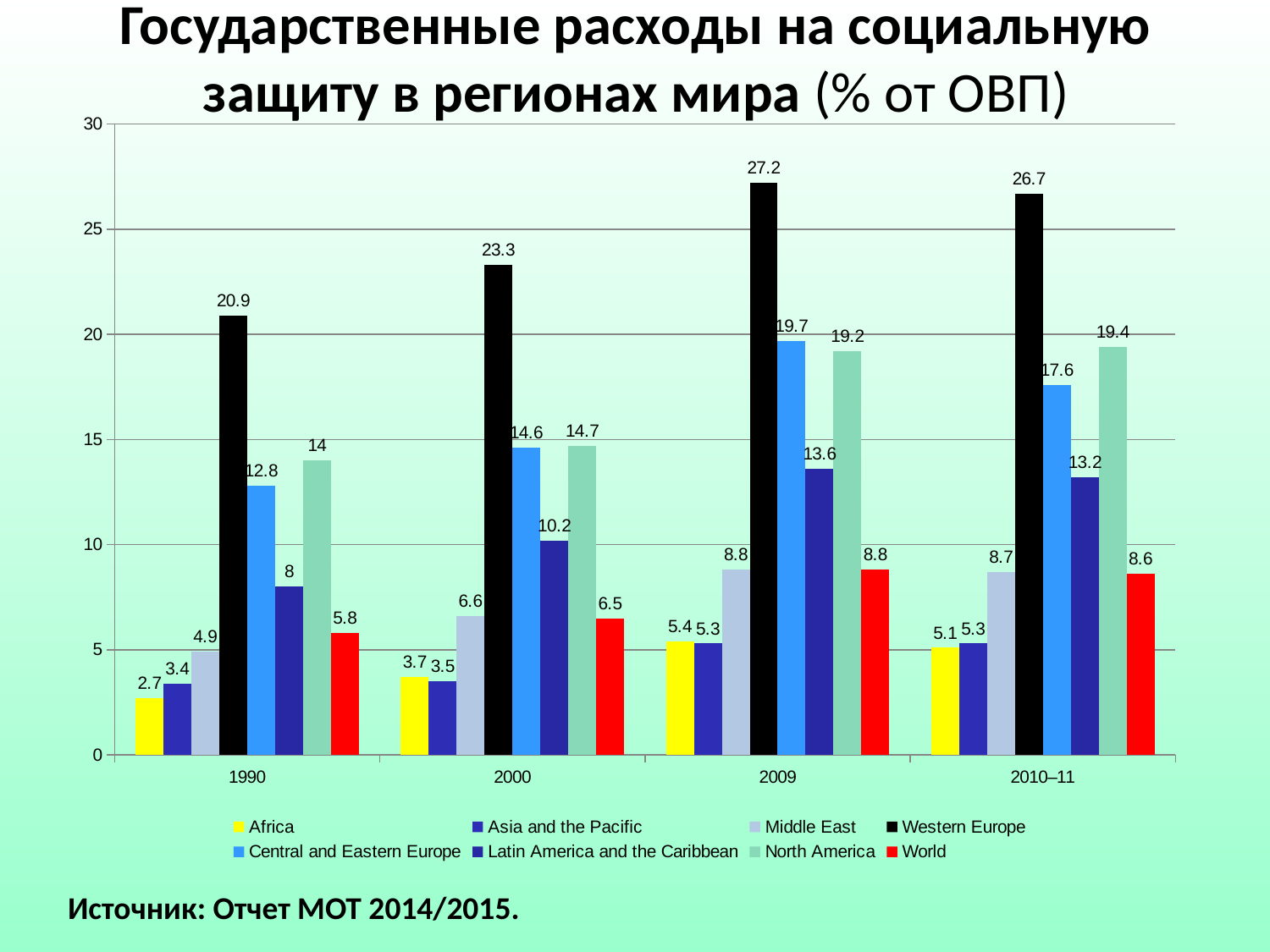
What is the difference between the North America values for 2010–11 and 2000? 4.7 Which region has the highest value in 2000? Western Europe What is the value for Western Europe in 2009? 27.2 Which region has the lowest value in 1990? Africa What is the value for World in 1990? 5.8 What kind of chart is shown on the slide? Bar chart In 2009, which is larger: Central and Eastern Europe or North America? Central and Eastern Europe Does the value for Western Europe rise or fall from 1990 to 2009? Rise What is the value for Latin America and the Caribbean in 2000? 10.2 How many time periods are shown on the x axis? 4 By how much did the value for Western Europe increase from 1990 to 2010–11? 5.8 How many series does the legend list? 8